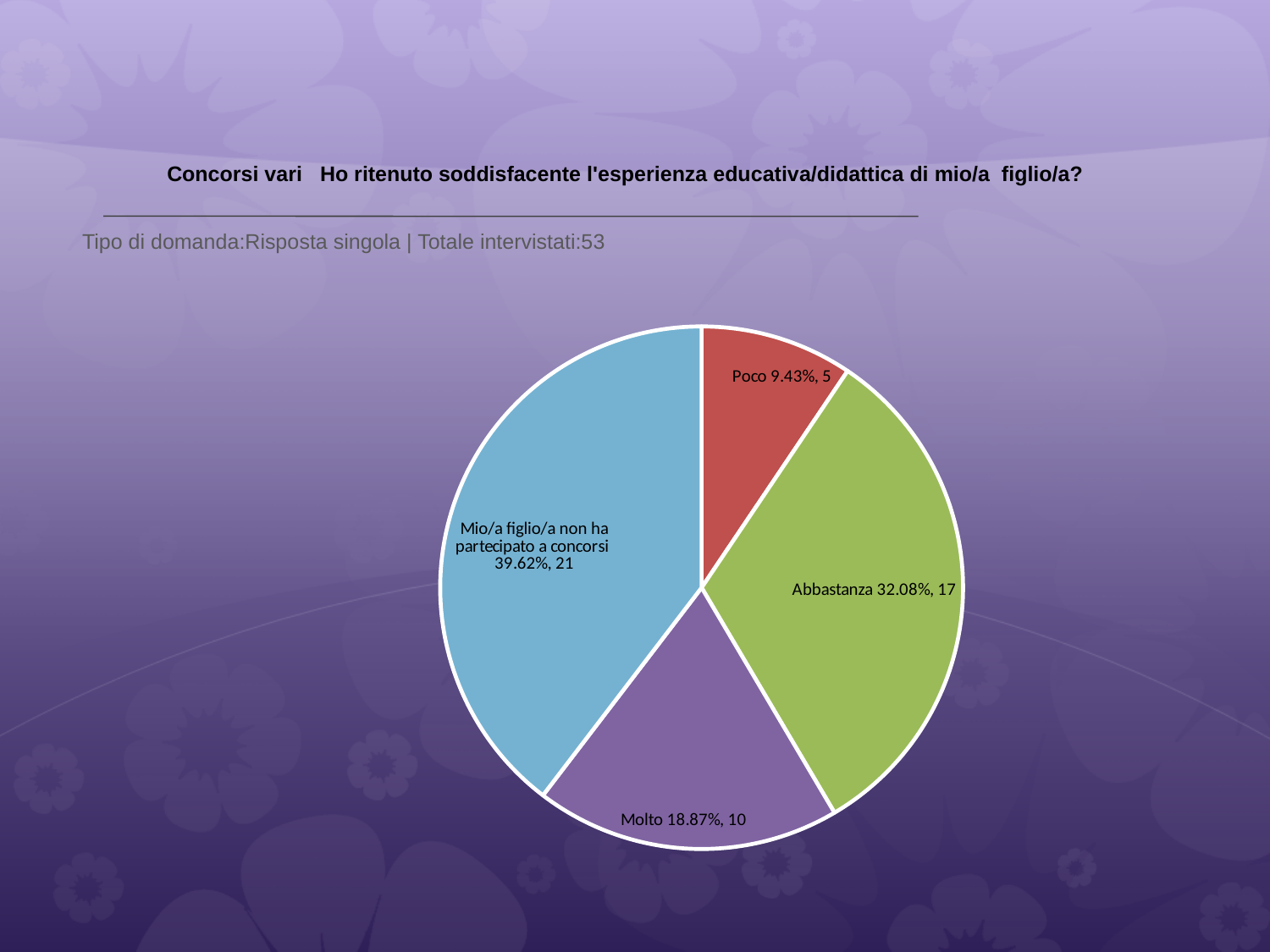
How many respondents answered 'Poco'? 5 What kind of chart is shown on the slide? pie chart What colour is the 'Abbastanza' slice? green What is the difference in respondent count between 'Abbastanza' and 'Molto'? 7 How many slices does the pie chart have? 4 What percentage share does the 'Mio/a figlio/a non ha partecipato a concorsi' slice have? 39.62% Which category has the largest slice? Mio/a figlio/a non ha partecipato a concorsi What percentage share does the 'Abbastanza' slice have? 32.08% What is the total number of respondents shown in the subtitle? 53 How many respondents answered 'Molto'? 10 Which has more respondents, 'Molto' or 'Poco'? Molto Which category has the smallest slice? Poco